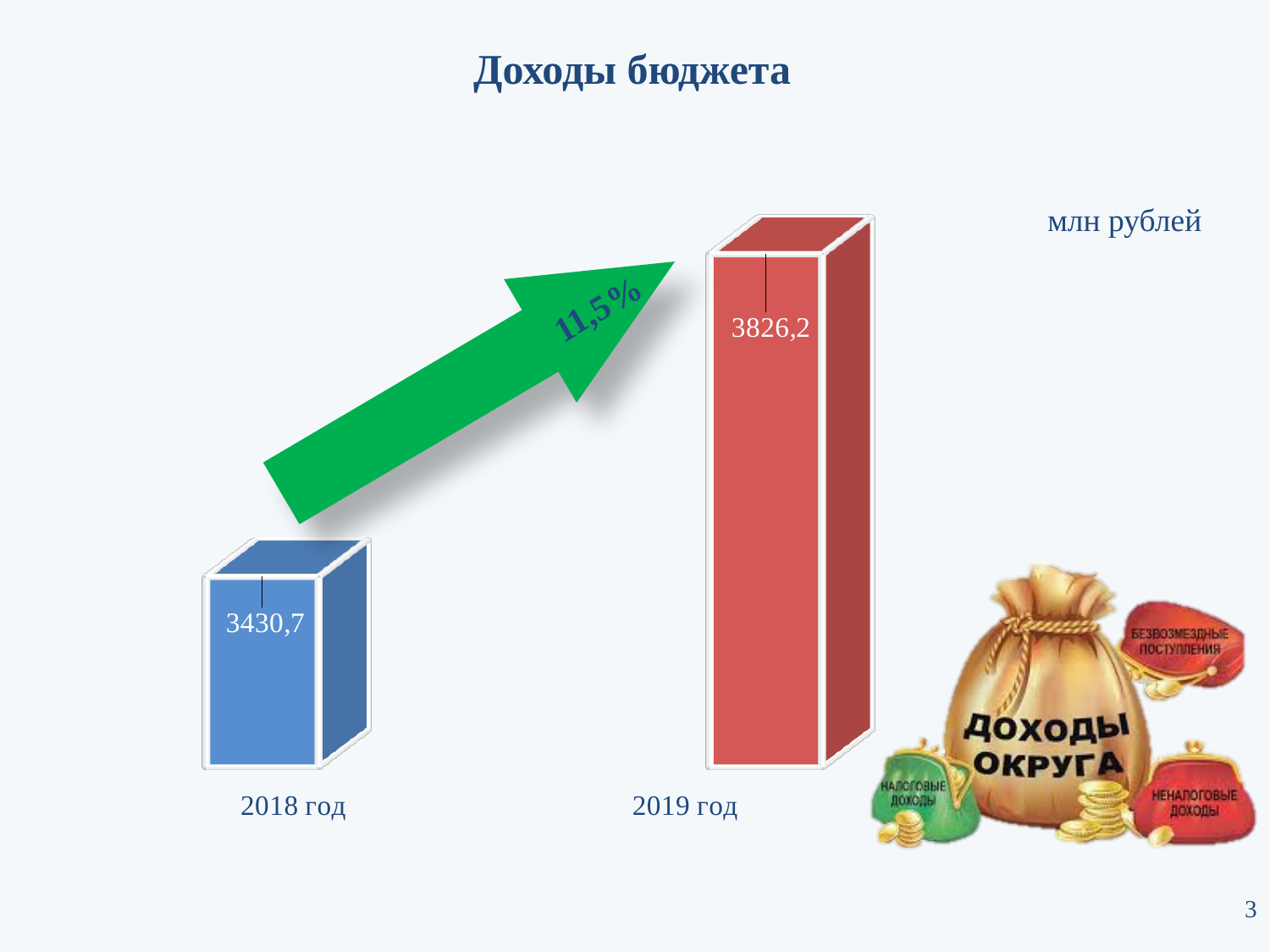
What is the title of the chart? Доходы бюджета What kind of chart is shown on the slide? bar chart Do the values rise or fall from 2018 год to 2019 год? rise Which is larger, the value for 2018 год or the value for 2019 год? 2019 год How many bars are shown in the chart? 2 What is the value for 2018 год? 3430,7 Which year has the highest value? 2019 год What percentage growth is shown on the arrow between the two bars? 11,5% What is the value for 2019 год? 3826,2 What unit is indicated for the values in the chart? млн рублей What is the difference between the values for 2019 год and 2018 год? 395,5 Which year has the lowest value? 2018 год